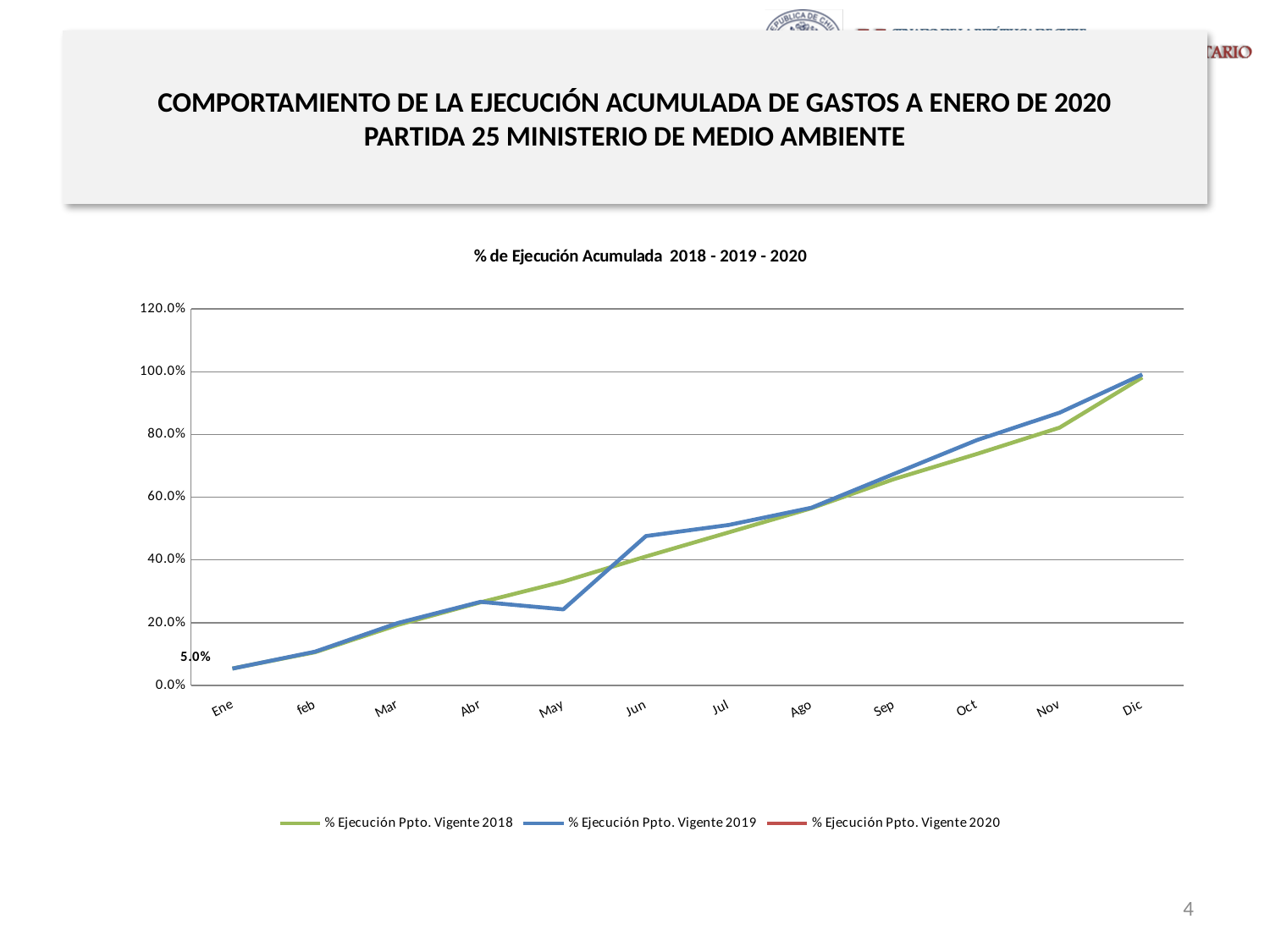
In which month does the % Ejecución Ppto. Vigente 2019 series reach its highest value? Dic Is the value for % Ejecución Ppto. Vigente 2018 in Jun greater or less than 60.0%? less Do the values of the % Ejecución Ppto. Vigente 2019 series rise or fall from Ene to Dic? rise How many series does the legend list? 3 Is the value for % Ejecución Ppto. Vigente 2019 in Jun greater or less than 40.0%? greater What is the title of the chart? % de Ejecución Acumulada 2018 - 2019 - 2020 Is the value for % Ejecución Ppto. Vigente 2019 in Dic greater or less than 80.0%? greater What kind of chart is shown on the slide? line chart What value is printed as a data label near Ene? 5.0% How many months are shown along the x axis? 12 In Nov, which series has the higher value, % Ejecución Ppto. Vigente 2018 or % Ejecución Ppto. Vigente 2019? % Ejecución Ppto. Vigente 2019 In May, which series has the higher value, % Ejecución Ppto. Vigente 2018 or % Ejecución Ppto. Vigente 2019? % Ejecución Ppto. Vigente 2018